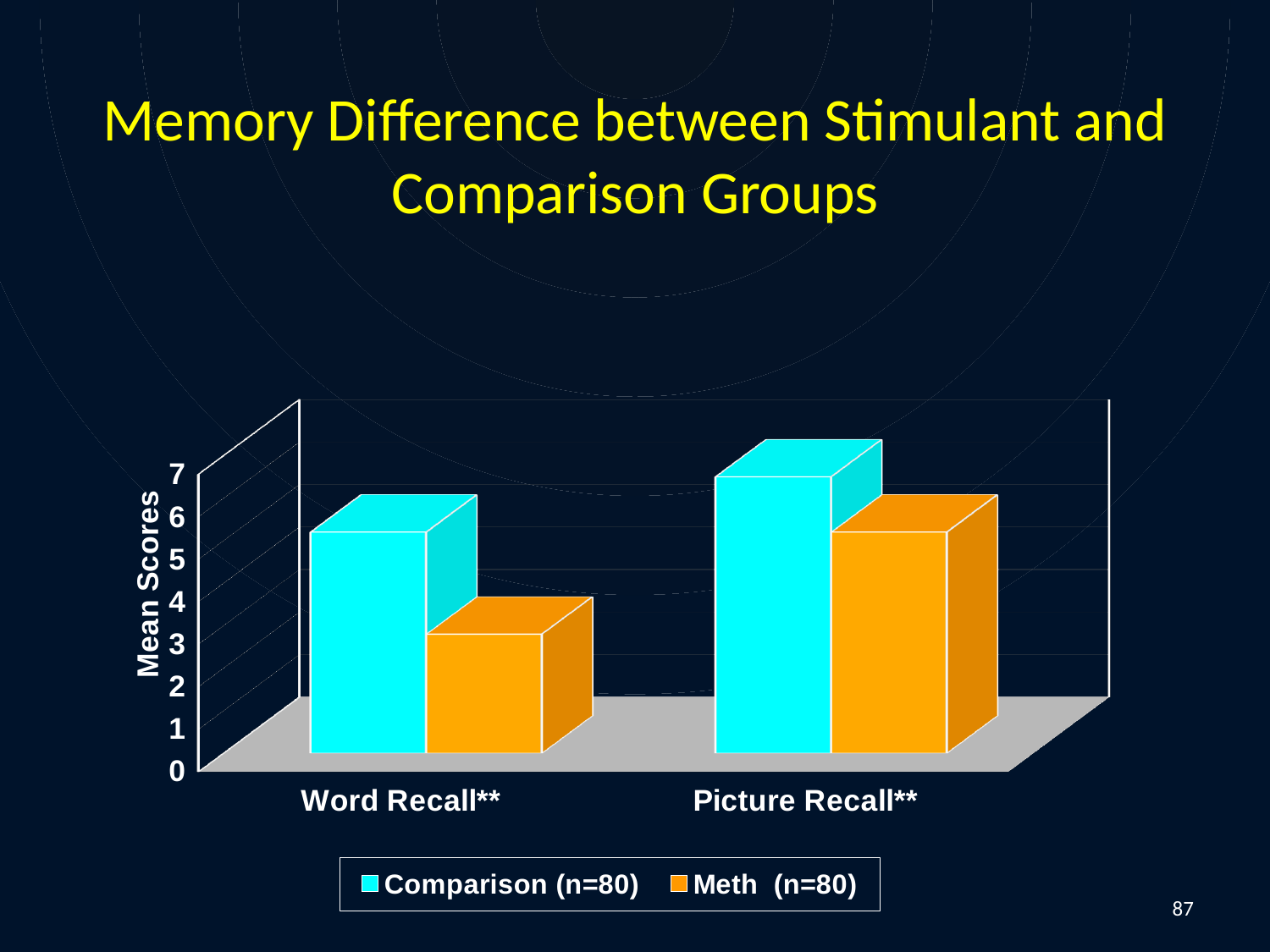
Is the value for Meth (n=80) in Picture Recall** greater or less than 4? greater For Word Recall**, which group has the higher mean score, Comparison (n=80) or Meth (n=80)? Comparison (n=80) Which bar in the chart is the highest? Comparison (n=80) for Picture Recall** How many series does the chart's legend list? 2 How many categories are shown on the x axis of the chart? 2 Which bar in the chart is the lowest? Meth (n=80) for Word Recall** Is the value for Meth (n=80) in Word Recall** greater or less than 5? less Is the value for Comparison (n=80) in Word Recall** greater or less than 4? greater For Picture Recall**, which group has the higher mean score, Comparison (n=80) or Meth (n=80)? Comparison (n=80) What is the title of the chart's vertical axis? Mean Scores What kind of chart is shown on the slide? bar chart